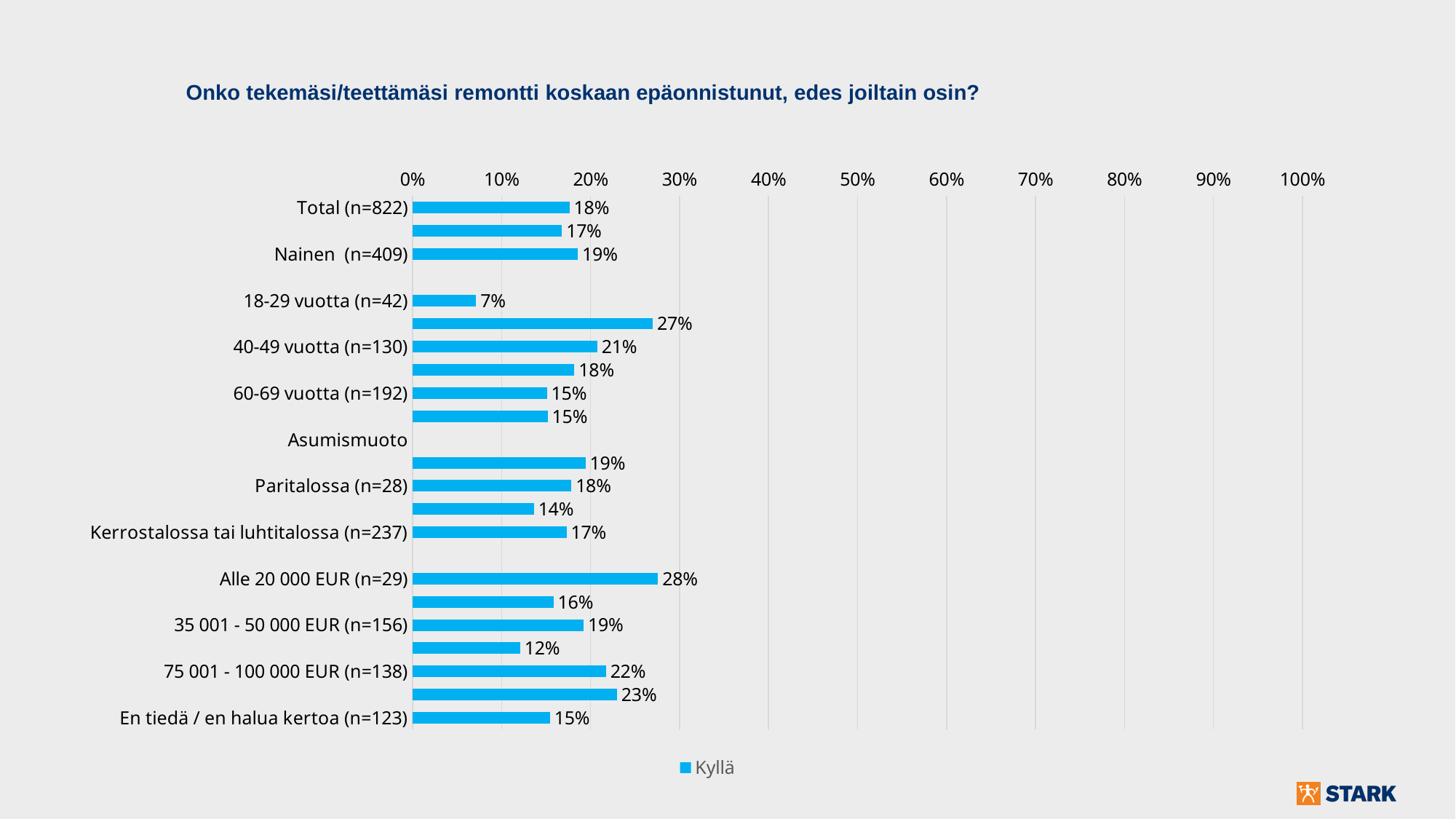
What is the value for 18-29 vuotta (n=42)? 7% What is the value for Kerrostalossa tai luhtitalossa (n=237)? 17% What is the value for Alle 20 000 EUR (n=29)? 28% What kind of chart is shown on the slide? Bar chart Is the value for Paritalossa (n=28) greater or less than 20%? less What is the difference between the values for 40-49 vuotta (n=130) and 60-69 vuotta (n=192)? 6% Which is larger, the value for 75 001 - 100 000 EUR (n=138) or the value for Nainen (n=409)? 75 001 - 100 000 EUR (n=138) Which labelled category has the highest value? Alle 20 000 EUR (n=29) What is the value for Total (n=822)? 18% What is the legend entry for the series shown? Kyllä Which labelled category has the lowest value? 18-29 vuotta (n=42) How many series does the legend list? 1